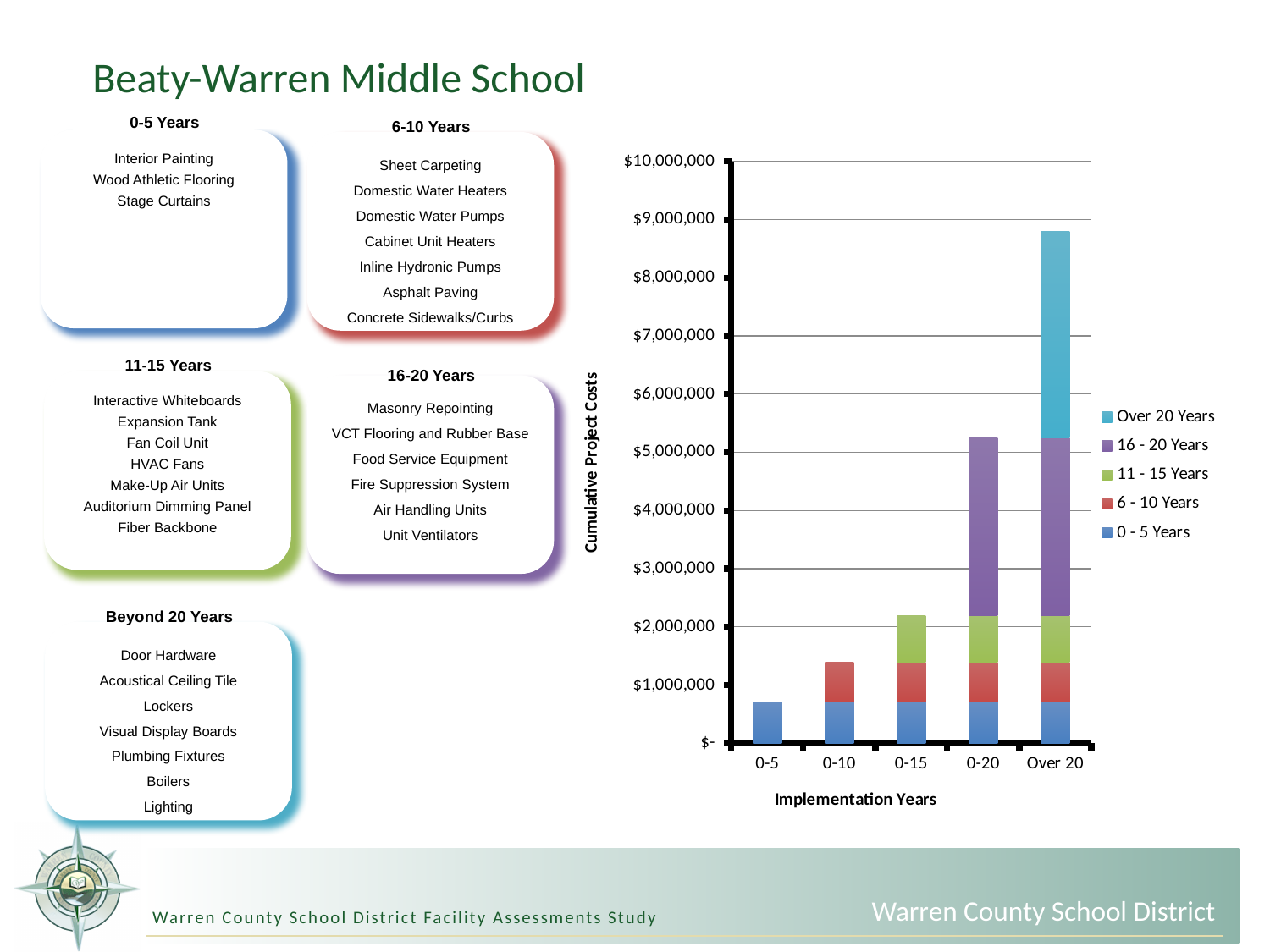
Which bar is taller, 0-10 or 0-20? 0-20 Which implementation year category has the tallest bar? Over 20 Is the total value for the Over 20 bar greater or less than $8,000,000? greater How many bars (implementation year categories) are plotted on the x axis? 5 How many series does the chart legend list? 5 Do the bar totals rise or fall moving from 0-5 to Over 20 along the x axis? rise Is the total value for the 0-15 bar greater or less than $2,000,000? greater Is the total value for the 0-20 bar greater or less than $5,000,000? greater Which implementation year category has the shortest bar? 0-5 What kind of chart is shown on the slide? Stacked bar chart What is the label of the chart's y axis? Cumulative Project Costs